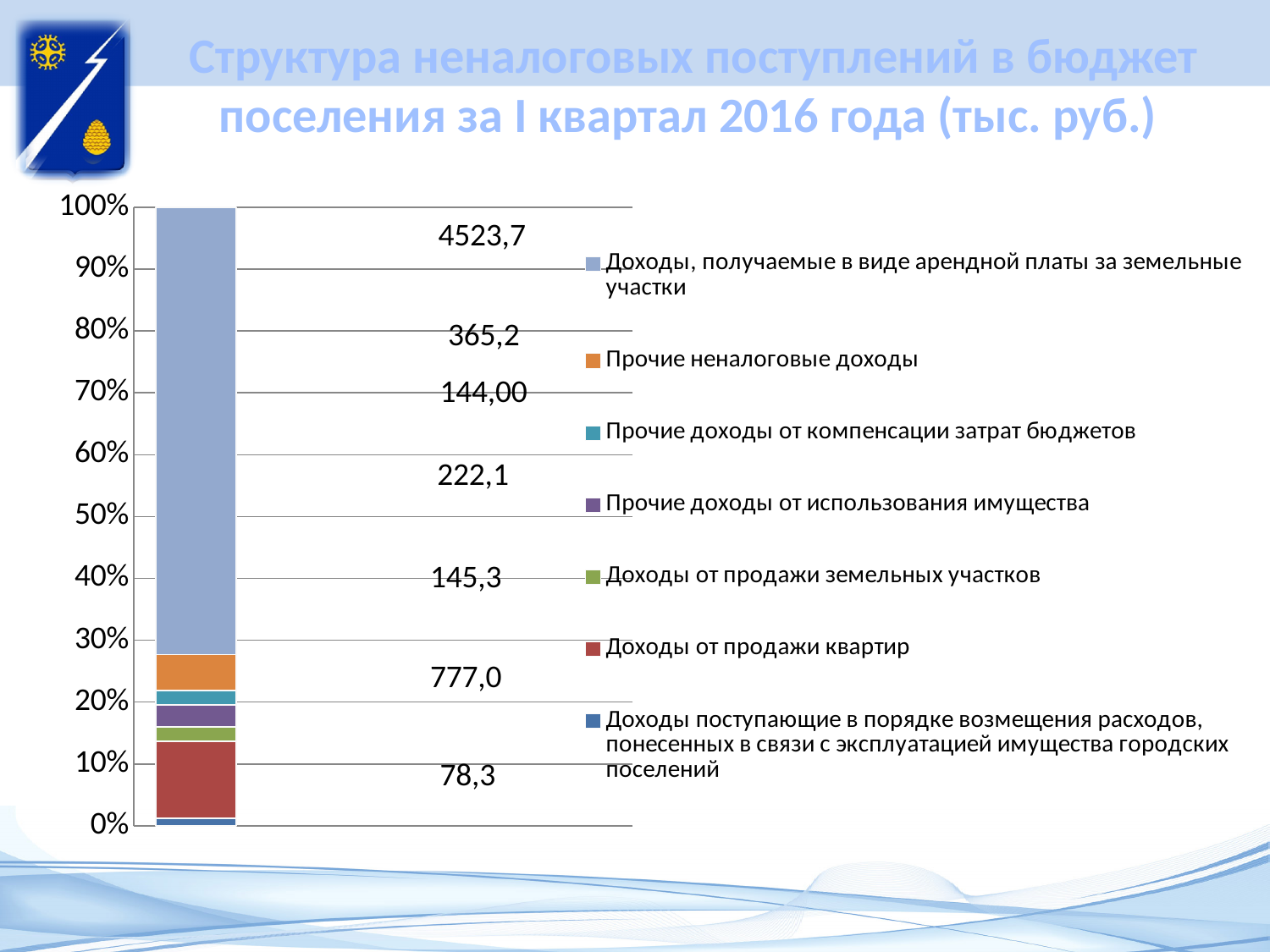
What is the value for «Доходы, получаемые в виде арендной платы за земельные участки»? 4523,7 What kind of chart is shown on the slide? stacked bar chart How many series does the legend list? 7 What is the total of all the values in the stacked bar? 6255,6 What is the value for «Доходы поступающие в порядке возмещения расходов, понесенных в связи с эксплуатацией имущества городских поселений»? 78,3 Which is larger: «Прочие доходы от использования имущества» or «Доходы от продажи земельных участков»? Прочие доходы от использования имущества What is the difference between «Доходы от продажи квартир» and «Доходы поступающие в порядке возмещения расходов»? 698,7 What is the value for «Прочие неналоговые доходы»? 365,2 Which series has the lowest value? Доходы поступающие в порядке возмещения расходов, понесенных в связи с эксплуатацией имущества городских поселений What is the value for «Прочие доходы от компенсации затрат бюджетов»? 144,00 What is the value for «Доходы от продажи квартир»? 777,0 Which series has the highest value? Доходы, получаемые в виде арендной платы за земельные участки